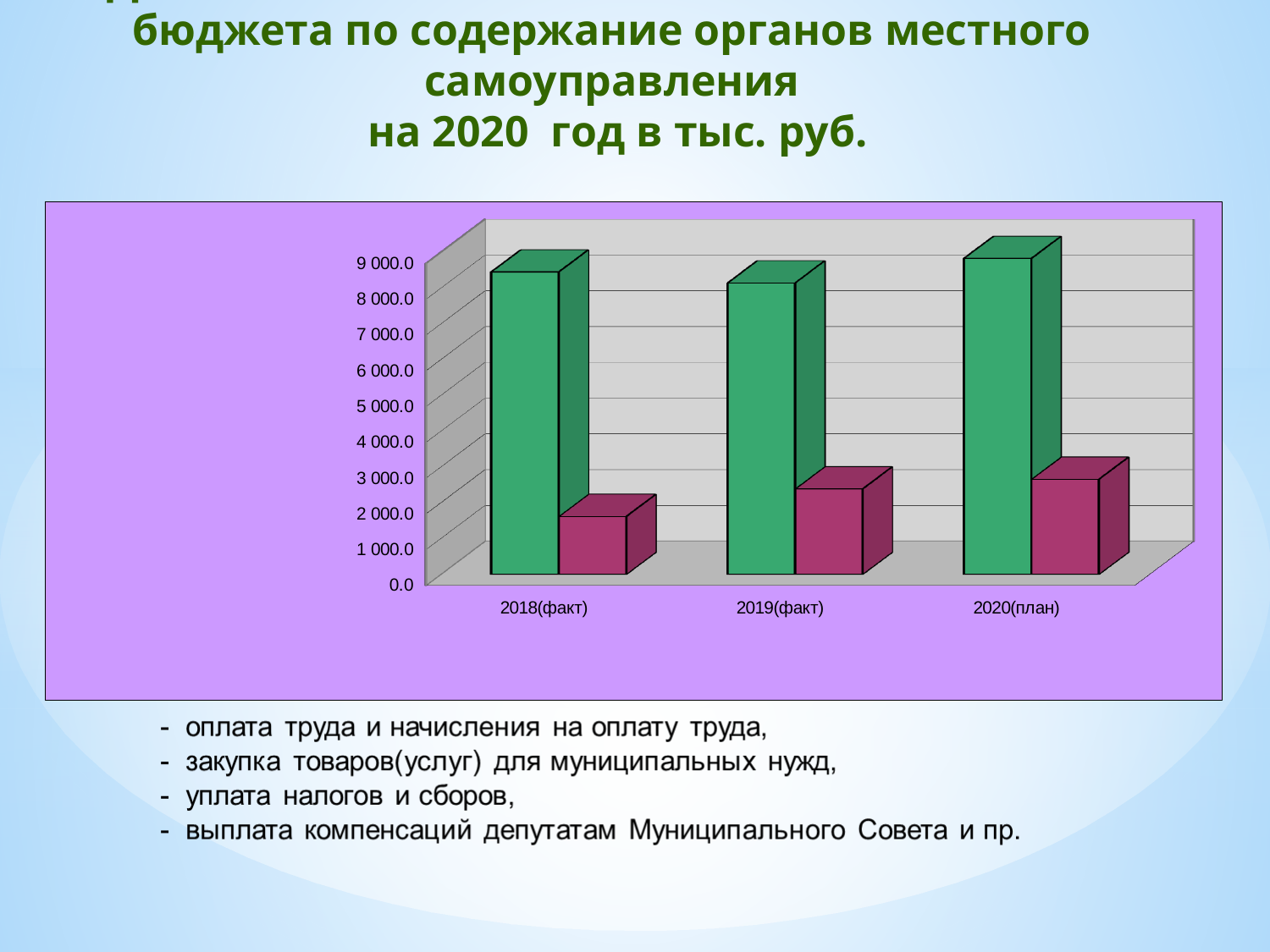
What kind of chart is shown on the slide? bar chart Is the value of the magenta bar for 2018(факт) greater or less than 3 000.0? less Is the value of the green bar for 2020(план) greater or less than 8 000.0? greater How many categories are shown on the x axis of the chart? 3 Is the value of the green bar for 2019(факт) greater or less than 7 000.0? greater Among the magenta bars, which category has the lowest value? 2018(факт) How many bars are shown for each year category in the chart? 2 What is the highest tick value shown on the vertical axis of the chart? 9 000.0 For 2020(план), which bar is larger, the green one or the magenta one? the green one